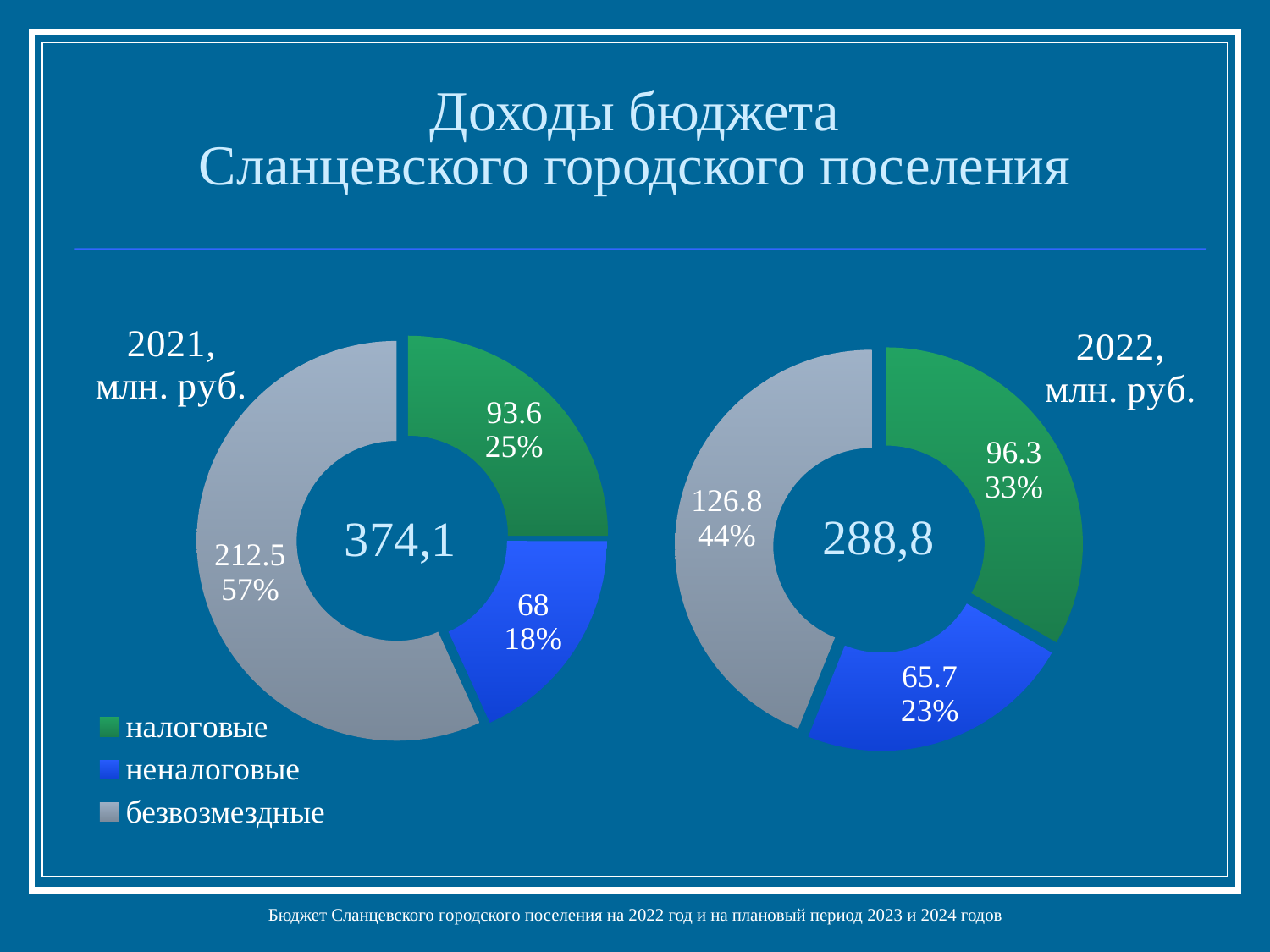
In the 2021 chart, what is the value for налоговые? 93.6 What total is shown in the centre of the 2022 chart? 288,8 In the 2022 chart, what share of the total do налоговые make up? 33% In the 2022 chart, what is the value for безвозмездные? 126.8 In the 2022 chart, which category has the smallest value? неналоговые What type of chart is used on this slide? Doughnut (pie) chart What is the difference between the безвозмездные value in the 2021 chart and in the 2022 chart? 85.7 How many categories does the legend list? 3 In the 2022 chart, what is the value for неналоговые? 65.7 In the 2021 chart, which category has the largest value? безвозмездные In the 2021 chart, what share of the total do безвозмездные make up? 57% Which is larger: налоговые in the 2021 chart or налоговые in the 2022 chart? 2022 (96.3)